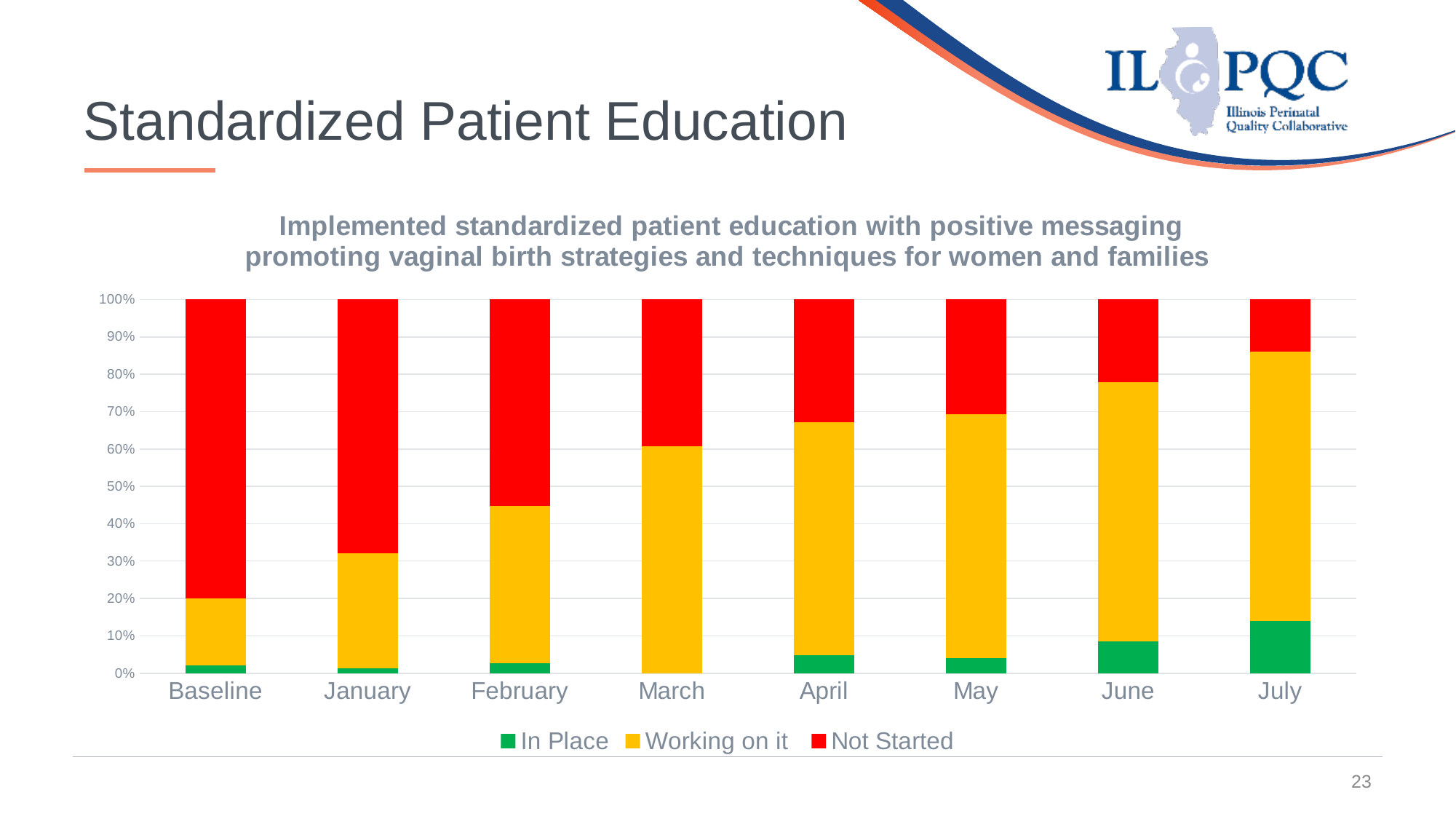
Is the 'Not Started' share for Baseline greater or less than 70%? greater Which category has the largest 'Not Started' segment? Baseline Does the 'Not Started' segment rise or fall from Baseline to July? Fall Which category has the smallest 'Not Started' segment? July Is the 'In Place' share for July greater or less than 10%? greater Which category has the largest 'In Place' segment? July How many series does the chart's legend list? 3 Is the 'Working on it' segment larger for March or for January? March What kind of chart is shown on the slide? Stacked bar chart How many categories are shown along the x axis of the chart? 8 What colour represents the 'Not Started' series in the chart? Red Is the 'Not Started' share for July greater or less than 20%? less